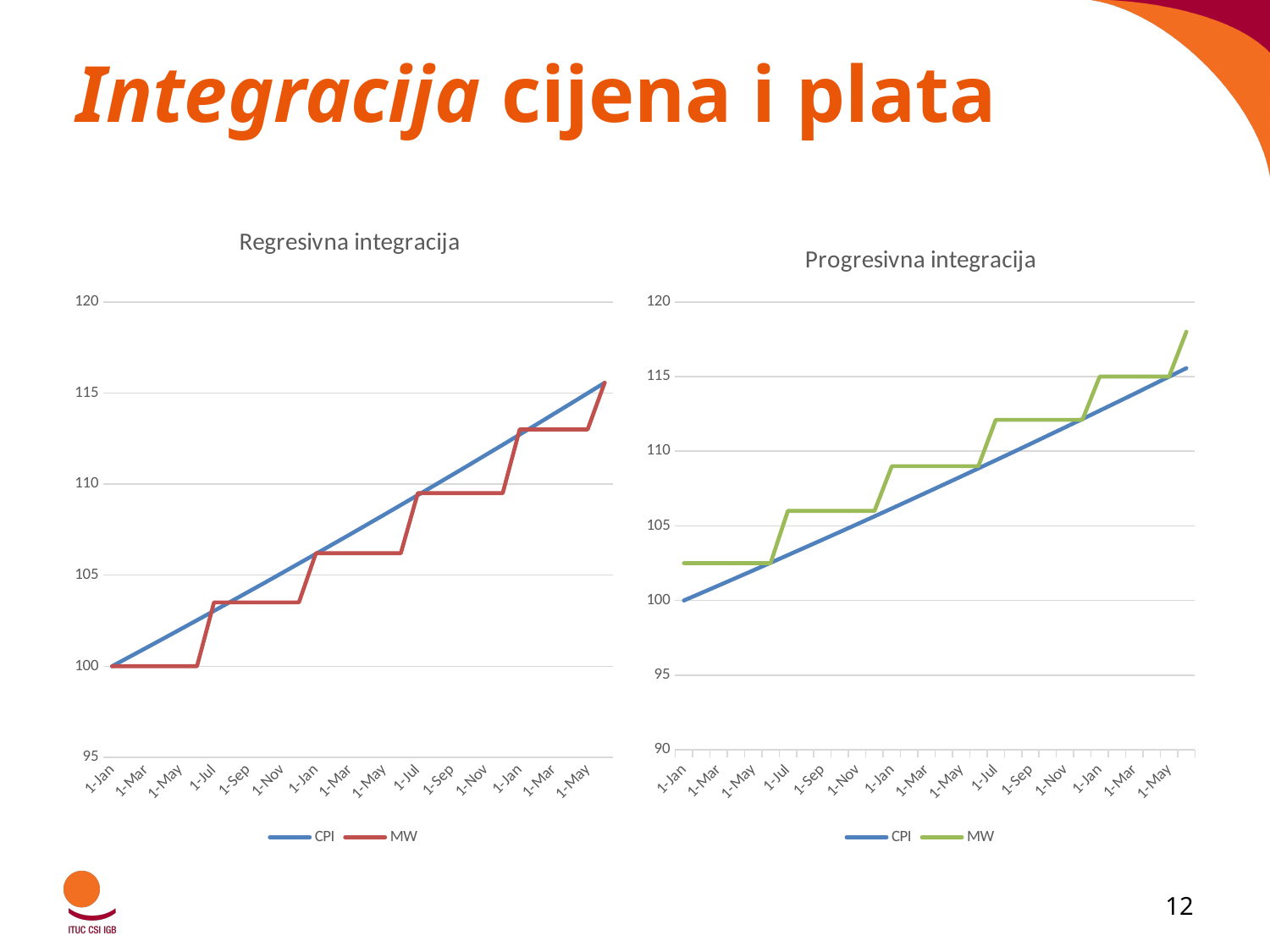
What are the two series named in the legend of the 'Regresivna integracija' chart? CPI and MW In the 'Progresivna integracija' chart, which series has the larger value at the first 1-Jul, CPI or MW? MW In the 'Progresivna integracija' chart, what is the value of CPI at the first 1-Jan? 100 How many series does the legend of the 'Progresivna integracija' chart list? 2 In the 'Regresivna integracija' chart, what is the value of CPI at the first 1-Jan? 100 In the 'Progresivna integracija' chart, is the value of MW at the first 1-Nov greater or less than 105? greater What kind of chart is the 'Regresivna integracija' chart? line chart In the 'Regresivna integracija' chart, which series has the larger value at the first 1-May, CPI or MW? CPI What is the title of the chart on the right side of the slide? Progresivna integracija In the 'Regresivna integracija' chart, does the CPI line rise or fall along the x axis? rise In the 'Regresivna integracija' chart, is the value of MW at the first 1-Sep greater or less than 100? greater